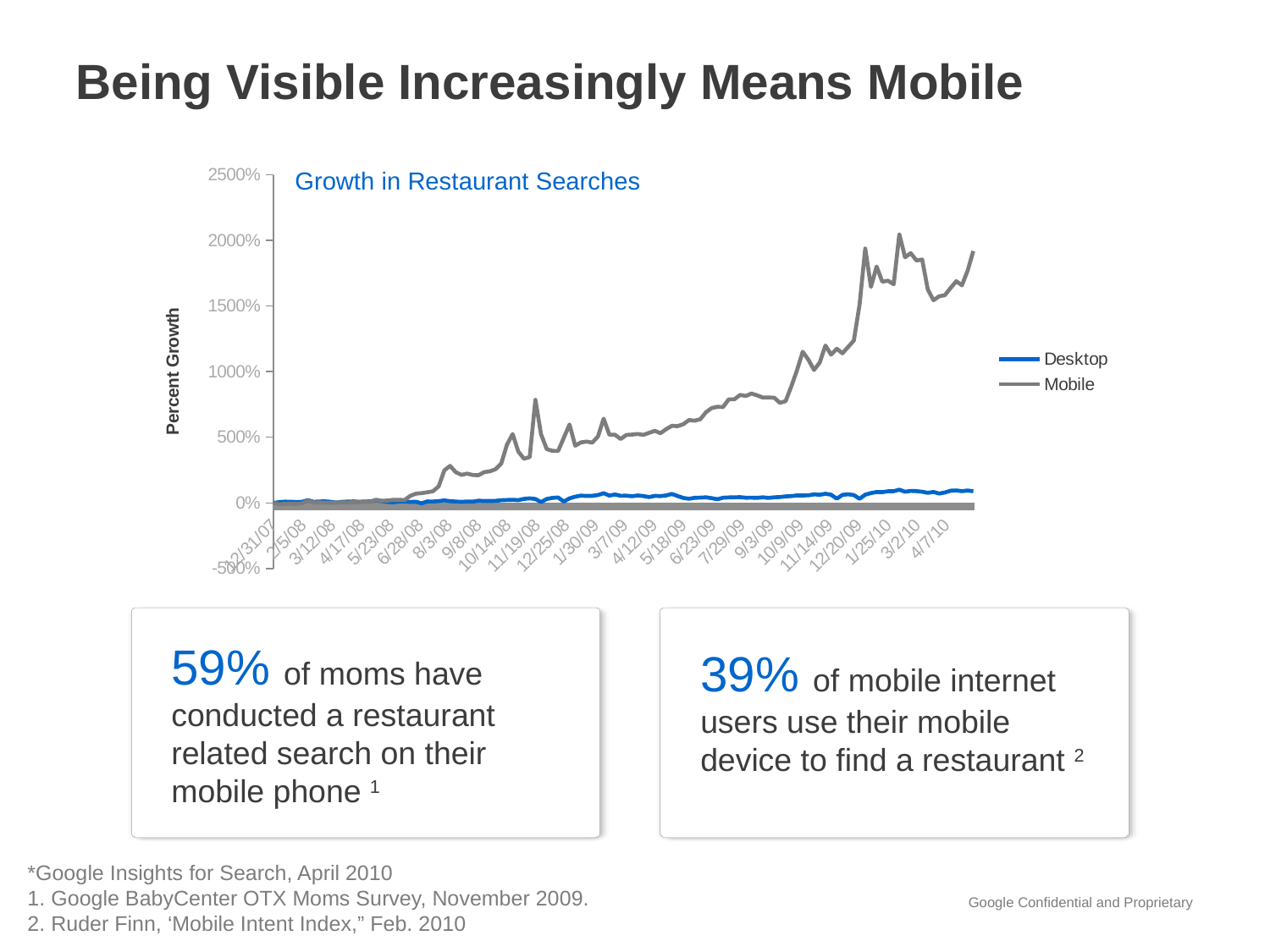
Which series, Desktop or Mobile, has the higher value at the end of the period (4/7/10)? Mobile What kind of chart is shown on the slide? line chart What is the label on the vertical axis of the chart? Percent Growth What is the title of the chart? Growth in Restaurant Searches How many series does the legend of the chart list? 2 Is the Mobile value at 7/29/09 greater or less than 500%? greater Does the Mobile series generally rise or fall from 12/31/07 to 4/7/10? rise Which series shows the larger overall growth across the period, Desktop or Mobile? Mobile Is the Desktop value at 4/7/10 greater or less than 500%? less What is the highest value shown on the vertical axis of the chart? 2500% Is the Mobile value at 7/29/09 greater or less than 1500%? less